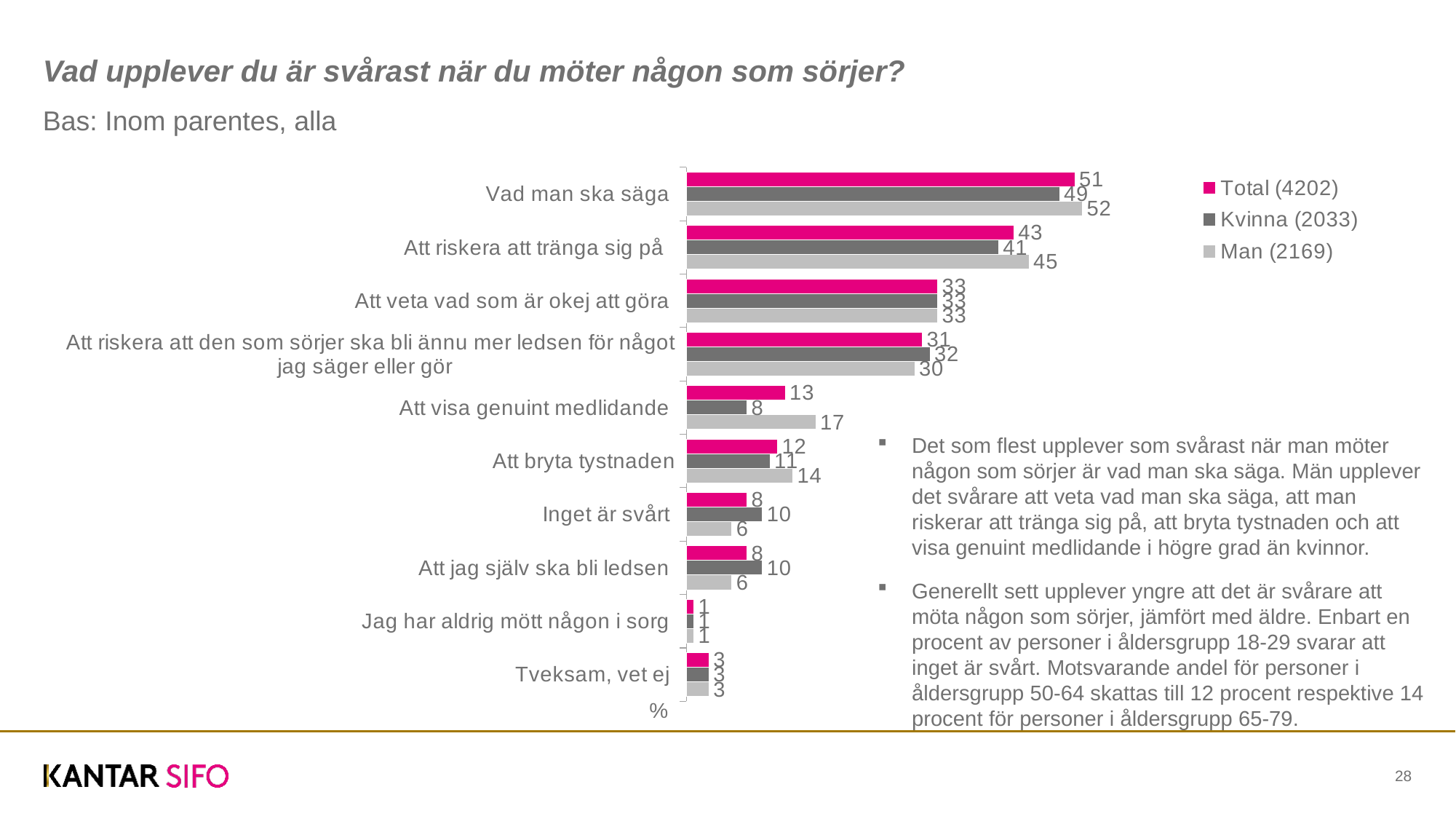
What is the Total (4202) value for "Vad man ska säga"? 51 How many categories are shown on the chart? 10 Which series is shown in pink/magenta in the legend? Total (4202) For "Inget är svårt", which is larger: the Kvinna (2033) value or the Man (2169) value? Kvinna (2033) How many series does the legend list? 3 What is the difference between the Total (4202) values for "Vad man ska säga" and "Att riskera att tränga sig på"? 8 Which category has the lowest Total (4202) value? Jag har aldrig mött någon i sorg What is the Man (2169) value for "Att riskera att tränga sig på"? 45 What is the difference between the Man (2169) and Kvinna (2033) values for "Att visa genuint medlidande"? 9 Which category has the highest Total (4202) value? Vad man ska säga What is the Kvinna (2033) value for "Att visa genuint medlidande"? 8 What kind of chart is shown on the slide? Bar chart